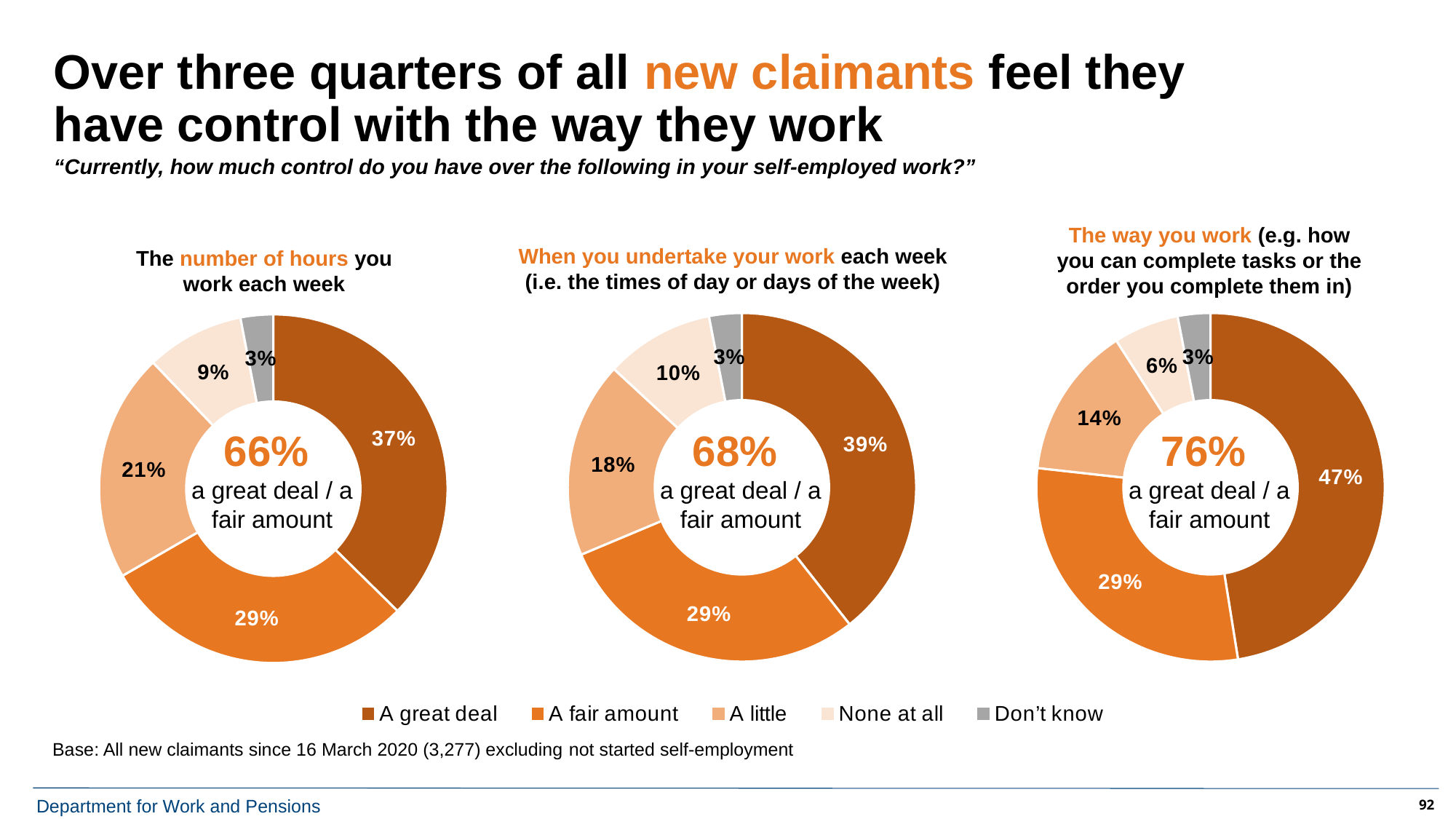
How many donut charts are shown on the slide? 3 In the 'The number of hours you work each week' chart, what percentage of new claimants said they have 'A great deal' of control? 37% In the 'The way you work' chart, what percentage said 'None at all'? 6% In the 'The number of hours you work each week' chart, which response category has the smallest share? Don't know How many response categories does the legend list? 5 What type of chart is used to show the responses on this slide? Donut (pie) chart In the 'When you undertake your work each week' chart, what is the difference between the 'A great deal' and 'A fair amount' shares? 10% In the 'When you undertake your work each week' chart, what percentage said 'A little'? 18% Is the 'A little' share larger in the 'The number of hours you work each week' chart or in the 'The way you work' chart? The number of hours you work each week What is the base size stated at the bottom of the slide? 3,277 What combined percentage for 'a great deal / a fair amount' is shown in the centre of the 'The way you work' chart? 76% In the 'The way you work' chart, which response category has the largest share? A great deal